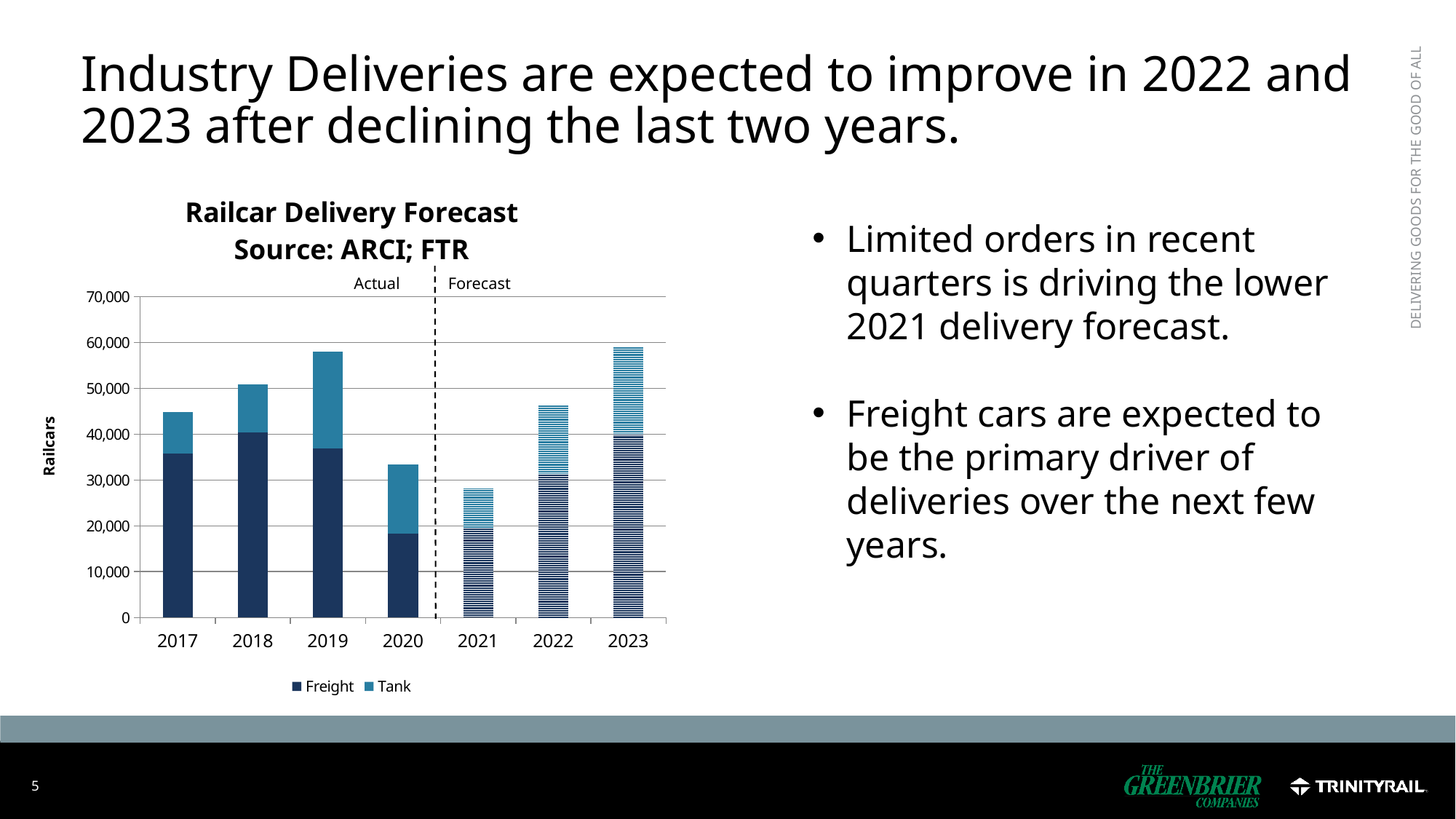
Is the total value for 2019 greater or less than 50,000? greater Which year has the lowest total railcar deliveries in the chart? 2021 What are the two series named in the chart legend? Freight and Tank Is the total value for 2022 greater or less than 50,000? less Which year has the larger total deliveries, 2019 or 2020? 2019 What kind of chart is shown on the slide? bar chart How many series does the legend of the Railcar Delivery Forecast chart list? 2 Is the total value for 2020 greater or less than 30,000? greater Do total railcar deliveries rise or fall from 2020 to 2023? rise How many years are shown on the x axis of the Railcar Delivery Forecast chart? 7 What is the label on the vertical axis of the chart? Railcars